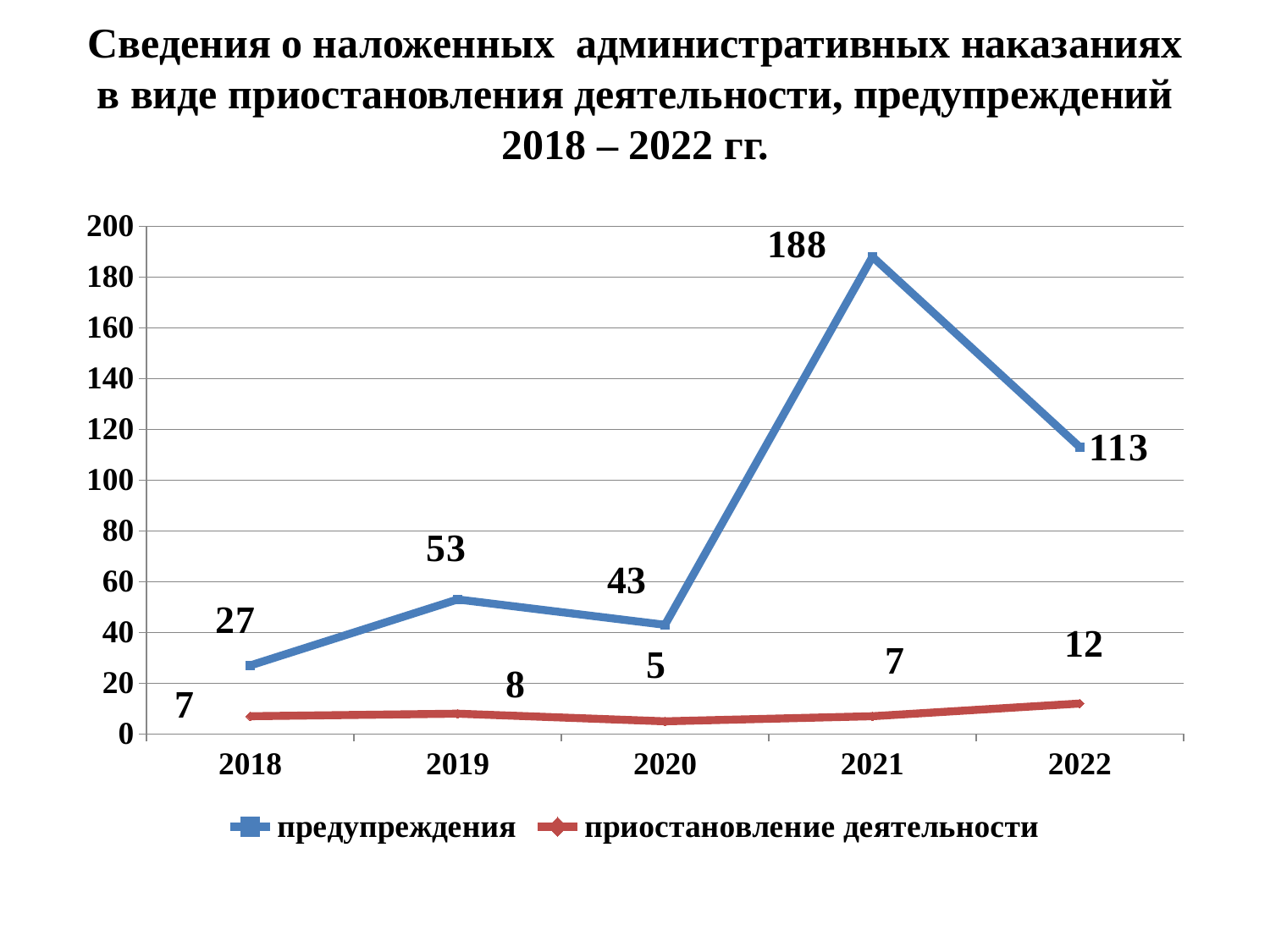
Which is larger, the предупреждения value for 2019 or for 2020? 2019 What kind of chart is shown on the slide? line chart What is the value for предупреждения in 2018? 27 What is the value for предупреждения in 2021? 188 In which year is the value for предупреждения highest? 2021 What is the value for приостановление деятельности in 2019? 8 What is the difference between the предупреждения values for 2021 and 2022? 75 How many years are shown on the x axis? 5 Is the value for предупреждения in 2022 greater or less than 100? greater In which year is the value for приостановление деятельности lowest? 2020 How many series does the legend list? 2 Does the value for предупреждения rise or fall from 2021 to 2022? fall